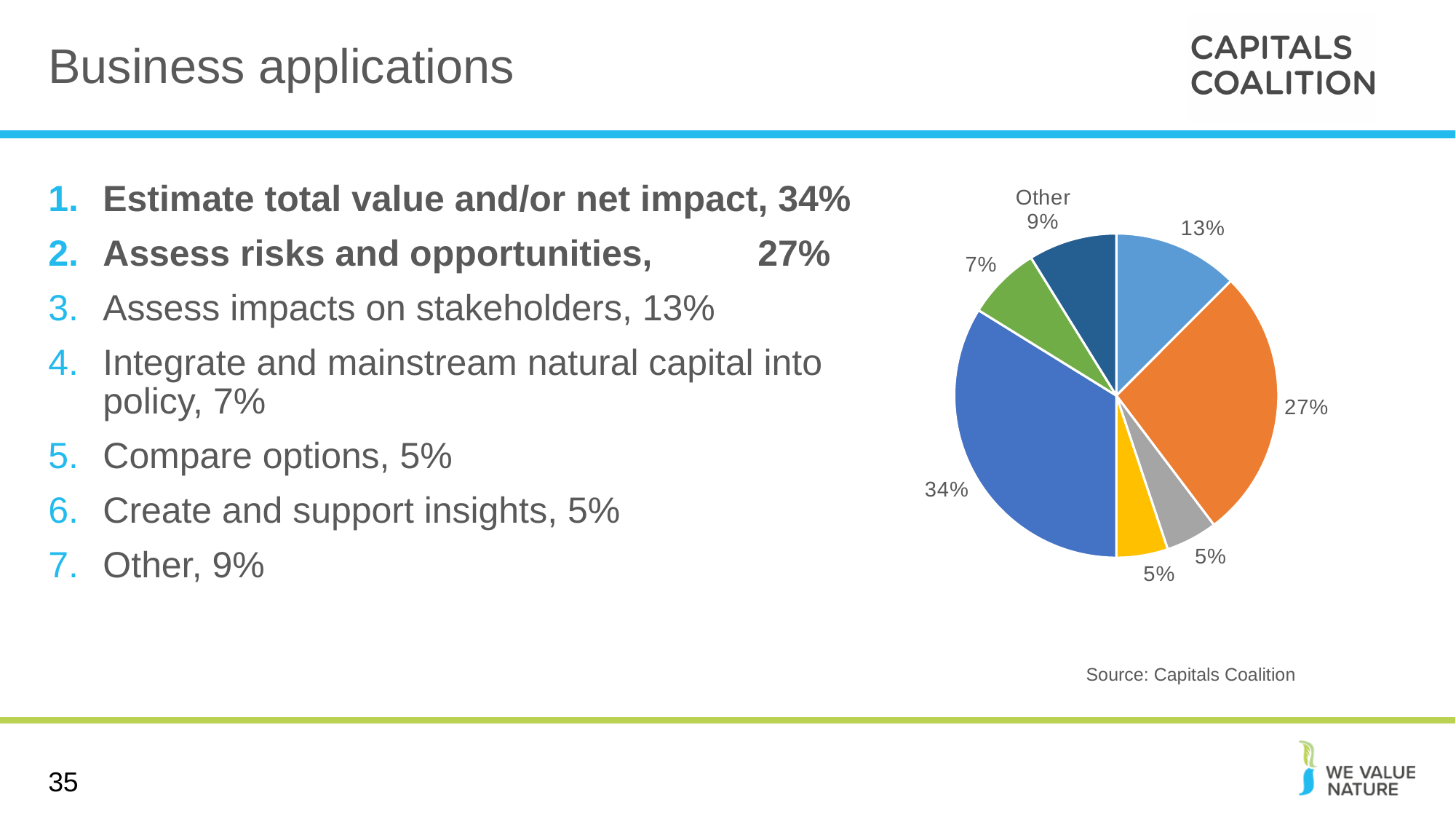
What kind of chart is shown on the slide? pie chart What is the combined share of the two 5% slices in the pie chart? 10% According to the slide, what share of the pie corresponds to "Assess impacts on stakeholders"? 13% What is the largest slice of the pie chart? 34% Which slice of the pie chart is the only one with a text label in addition to its percentage? Other What percentage is shown for the slice labelled "Other" in the pie chart? 9% According to the slide, what share of the pie corresponds to "Assess risks and opportunities"? 27% What is the source cited below the pie chart? Capitals Coalition How many slices in the pie chart are labelled 5%? 2 Which is larger in the pie chart: the 13% slice or the 7% slice? 13% What is the difference between the 34% slice and the 27% slice in the pie chart? 7% How many slices does the pie chart have? 7